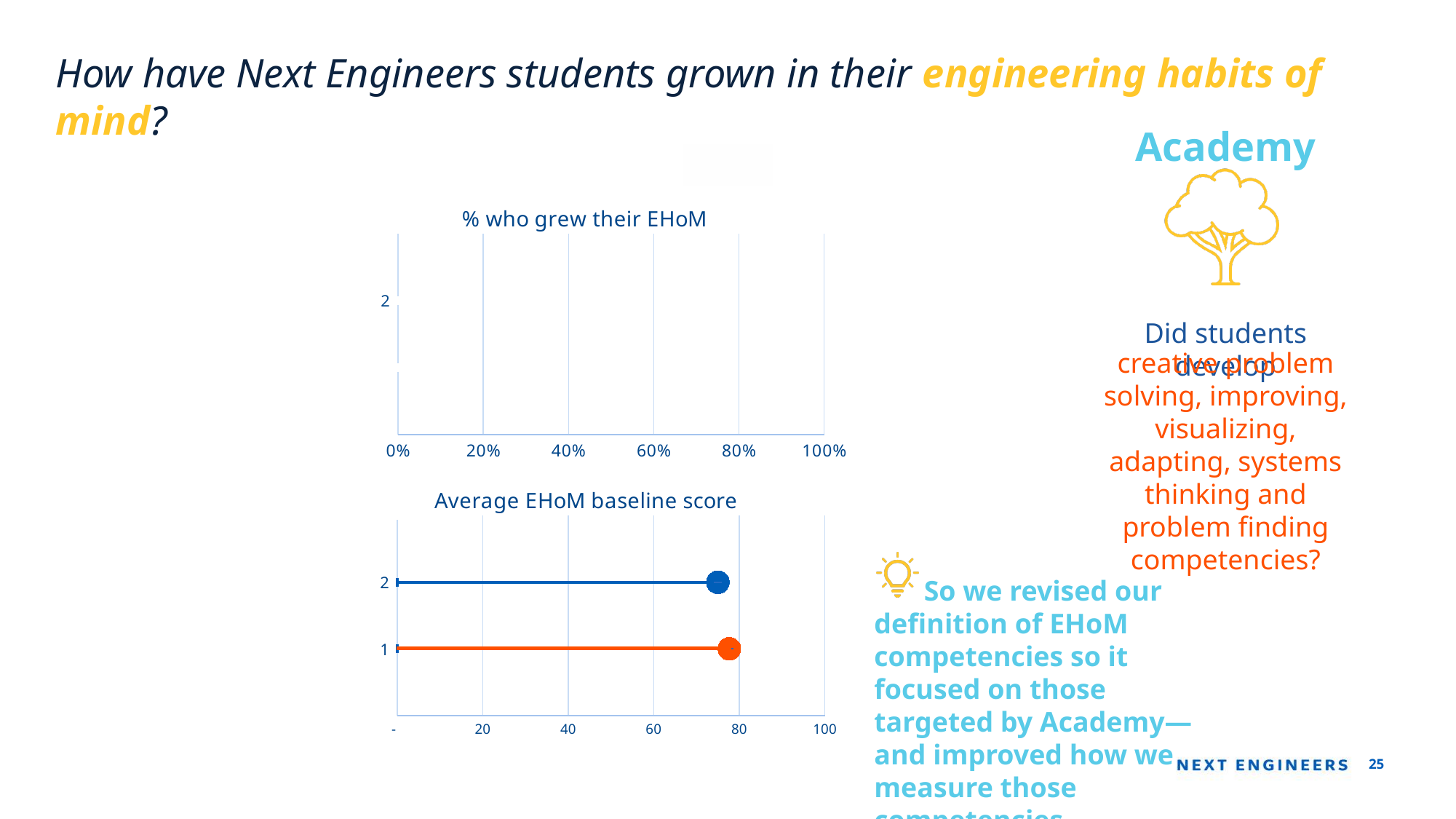
In the 'Average EHoM baseline score' chart, is the value for category 1 greater or less than 40? greater In the 'Average EHoM baseline score' chart, is the value for category 2 greater or less than 60? greater In the 'Average EHoM baseline score' chart, is the value for category 2 greater or less than 80? less In the 'Average EHoM baseline score' chart, how many categories are plotted? 2 In the 'Average EHoM baseline score' chart, what is the highest value shown on the x axis? 100 What kind of chart is the 'Average EHoM baseline score' chart? bar chart What is the title of the top chart on the slide? % who grew their EHoM What is the title of the bottom chart on the slide? Average EHoM baseline score